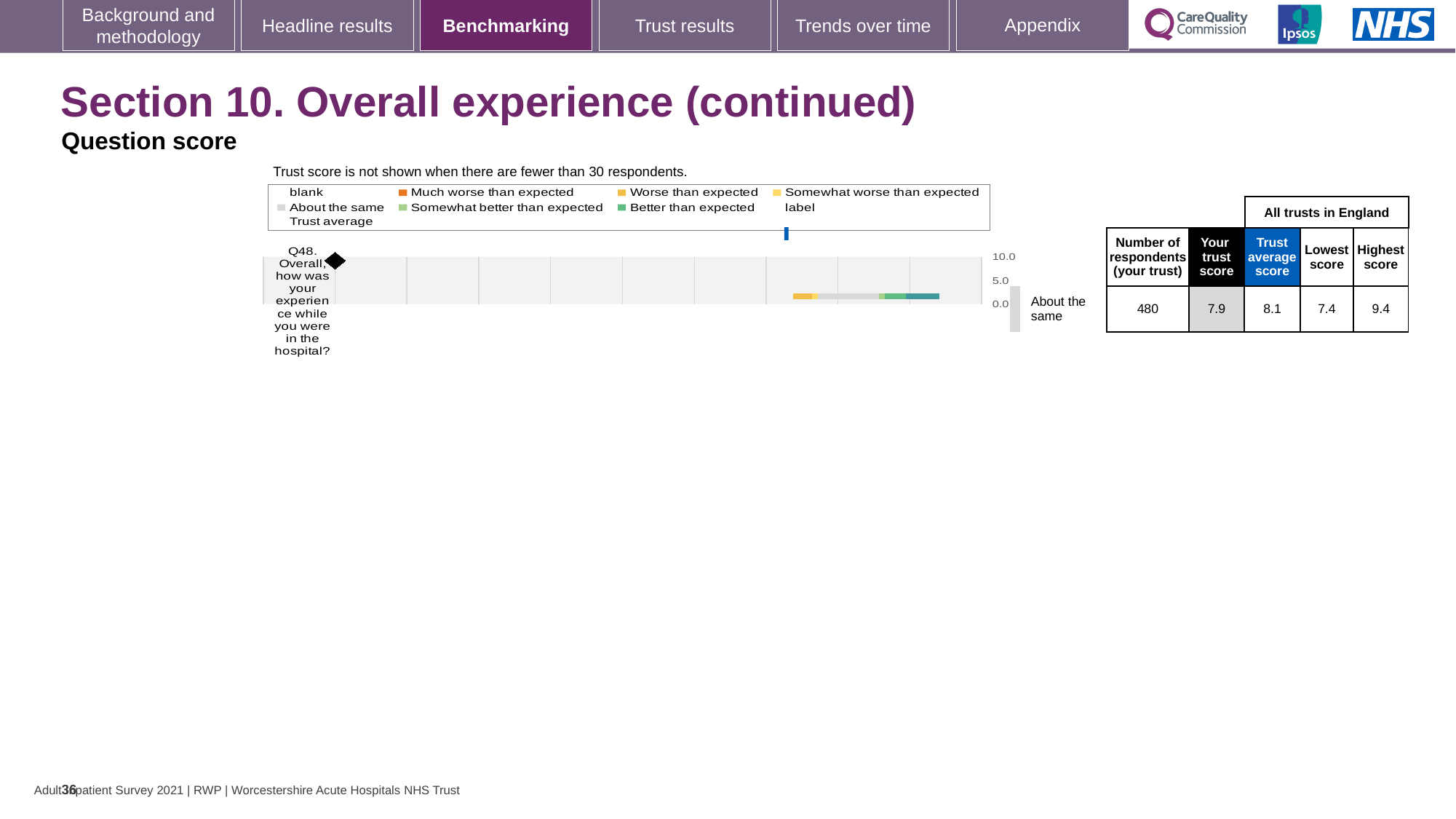
What benchmark category is shown next to the Q48 bar? About the same How many respondents from your trust answered Q48? 480 What is the highest score among all trusts in England for Q48? 9.4 Is your trust score for Q48 greater or less than 5.0 on the chart axis? greater What kind of chart is used to show the Q48 benchmarking result? bar chart What is the maximum value shown on the chart's score axis? 10.0 How many questions are plotted in the benchmarking chart? 1 What is the lowest score among all trusts in England for Q48? 7.4 What is the trust average score for Q48 across all trusts in England? 8.1 What is the 'Your trust score' for Q48, overall experience while in the hospital? 7.9 Which is larger for Q48: your trust score or the trust average score? Trust average score What is the difference between the highest score and the lowest score for Q48? 2.0